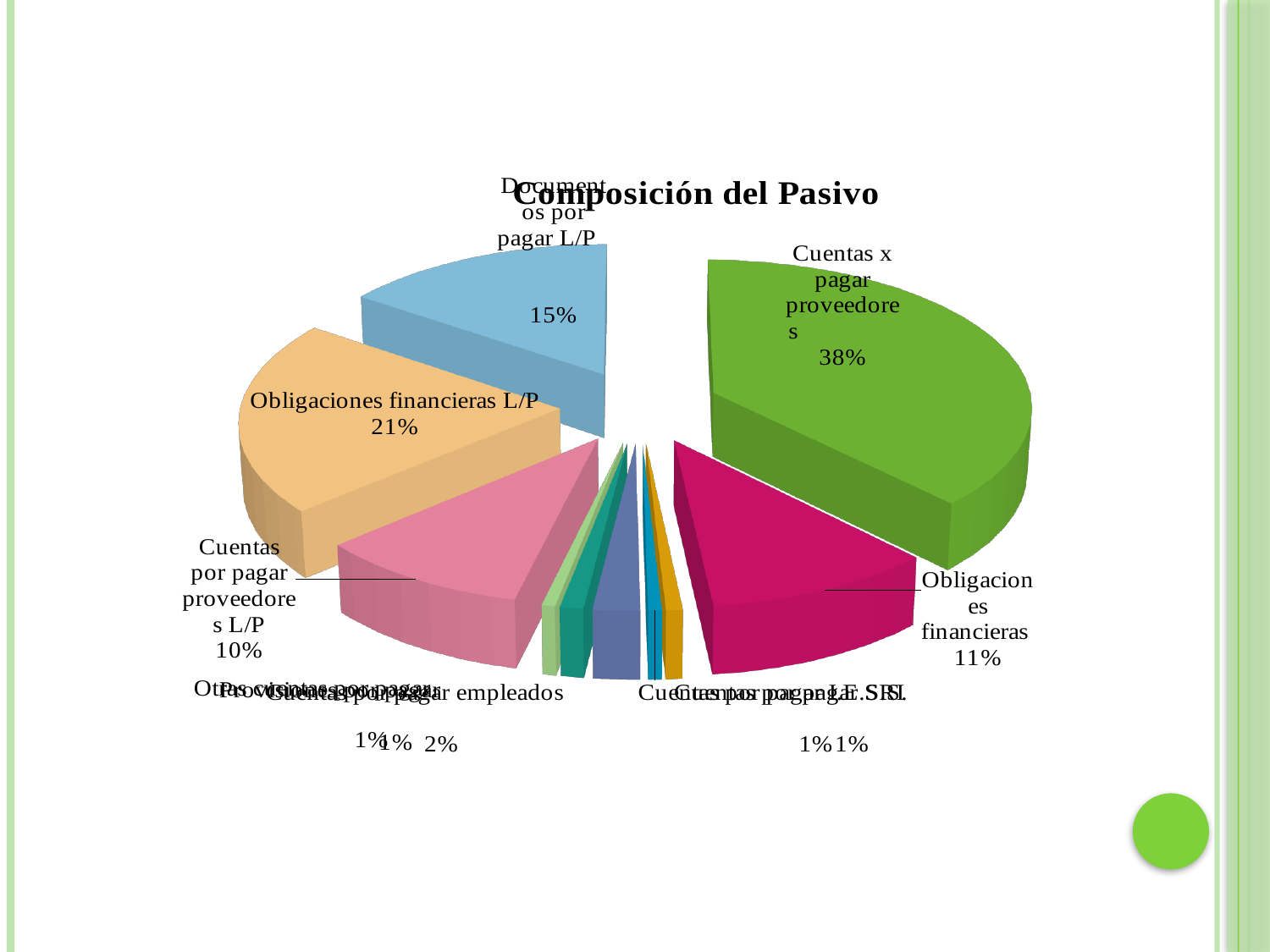
What colour is the slice for "Cuentas x pagar proveedores"? green Which is larger, the slice for "Obligaciones financieras L/P" or the slice for "Documentos por pagar L/P"? Obligaciones financieras L/P What is the title of the chart? Composición del Pasivo What share of the pie does "Cuentas x pagar proveedores" represent? 38% What kind of chart is shown on the slide? pie chart What percentage is shown for "Cuentas por pagar proveedores L/P"? 10% Which category has the largest slice of the pie? Cuentas x pagar proveedores What is the difference in percentage points between "Cuentas x pagar proveedores" and "Obligaciones financieras"? 27 percentage points What is the difference in percentage points between "Obligaciones financieras L/P" and "Cuentas por pagar proveedores L/P"? 11 percentage points What percentage is shown for "Documentos por pagar L/P"? 15% What percentage is shown for "Obligaciones financieras"? 11% What percentage is shown for "Obligaciones financieras L/P"? 21%